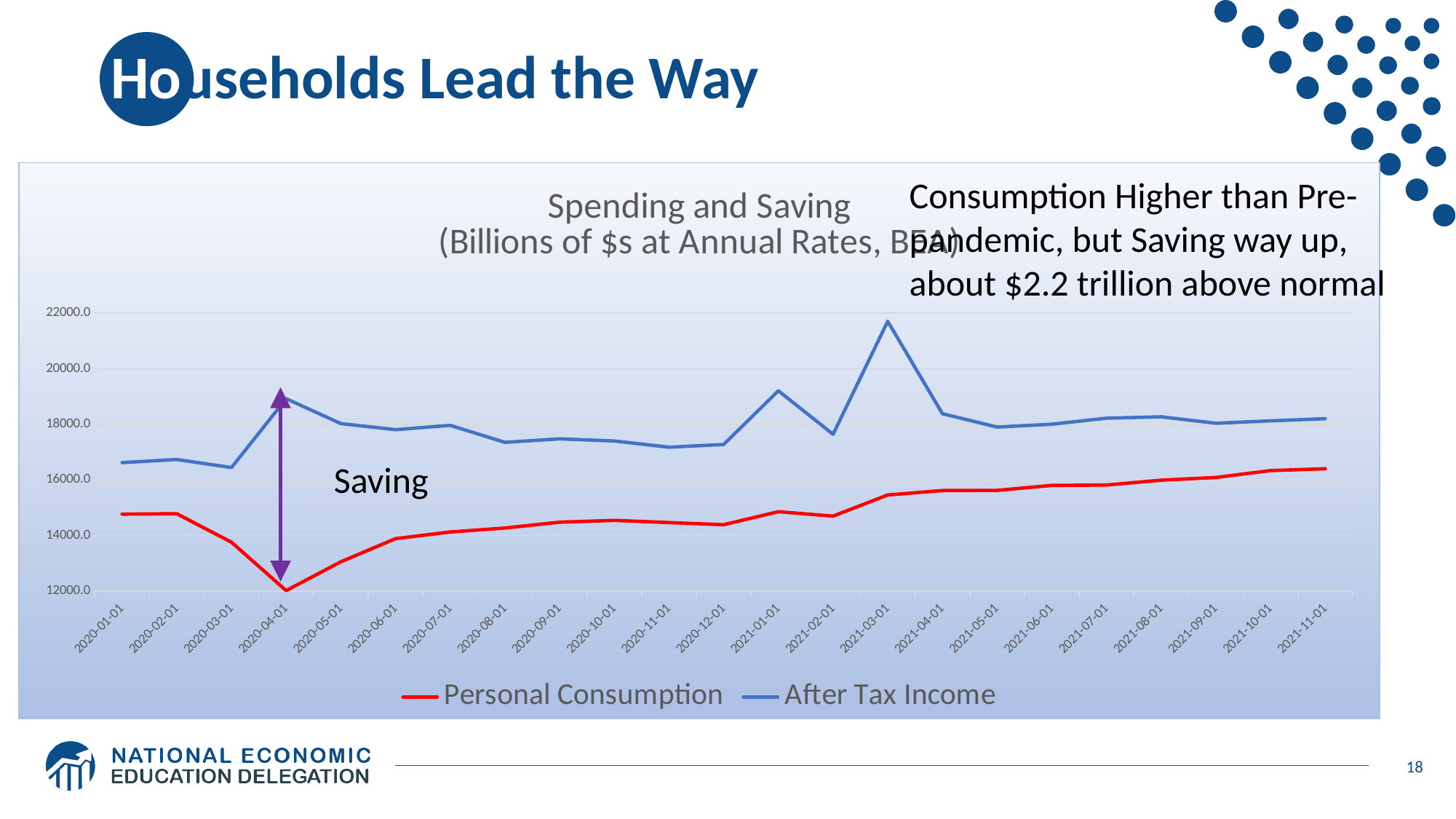
How many dates are shown along the x axis of the chart? 23 Is the value for Personal Consumption on 2020-04-01 greater or less than 14000.0? less What kind of chart is shown on the slide? line chart How many series does the chart legend list? 2 Does Personal Consumption rise or fall from 2020-04-01 to 2021-11-01? rise Is the value for After Tax Income on 2020-01-01 greater or less than 18000.0? less On which date does After Tax Income reach its highest value? 2021-03-01 On which date does Personal Consumption reach its lowest value? 2020-04-01 Is the value for Personal Consumption on 2021-11-01 greater or less than 16000.0? greater Which series has the larger value on 2020-04-01, Personal Consumption or After Tax Income? After Tax Income Which colour is used for the After Tax Income line? blue